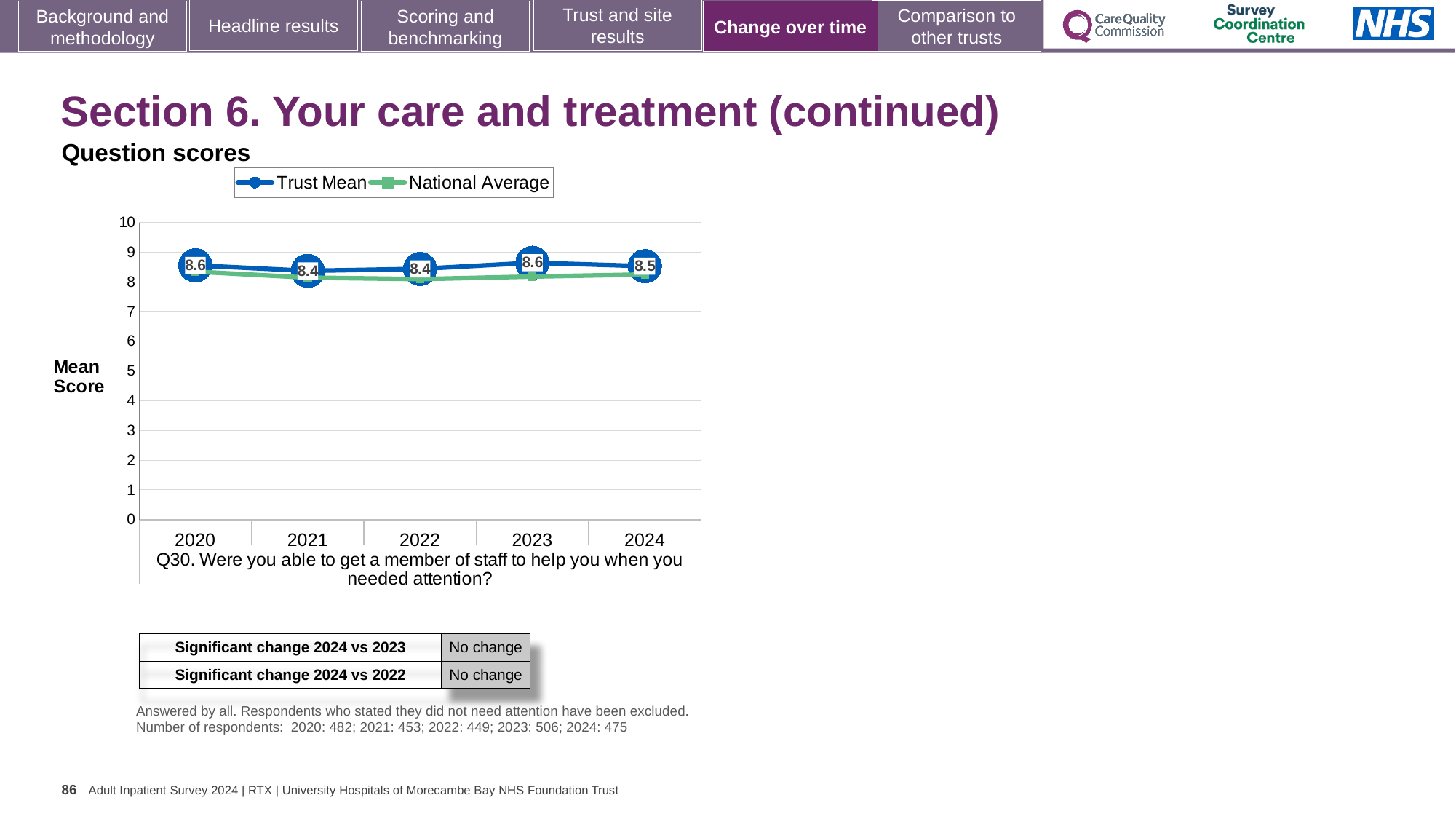
Which year has the larger Trust Mean score, 2020 or 2021? 2020 What is the Trust Mean score for 2023? 8.6 Is the Trust Mean value for 2022 greater or less than 7? greater How many series does the chart legend list? 2 What is the Trust Mean score for 2024? 8.5 What is the difference between the Trust Mean scores for 2023 and 2024? 0.1 Does the Trust Mean rise or fall from 2022 to 2023? Rise What kind of chart is shown on the slide? Line chart Is the National Average value for 2021 greater or less than 9? less What is the Trust Mean score for 2021? 8.4 How many years are shown on the x axis of the chart? 5 What is the Trust Mean score for 2020? 8.6